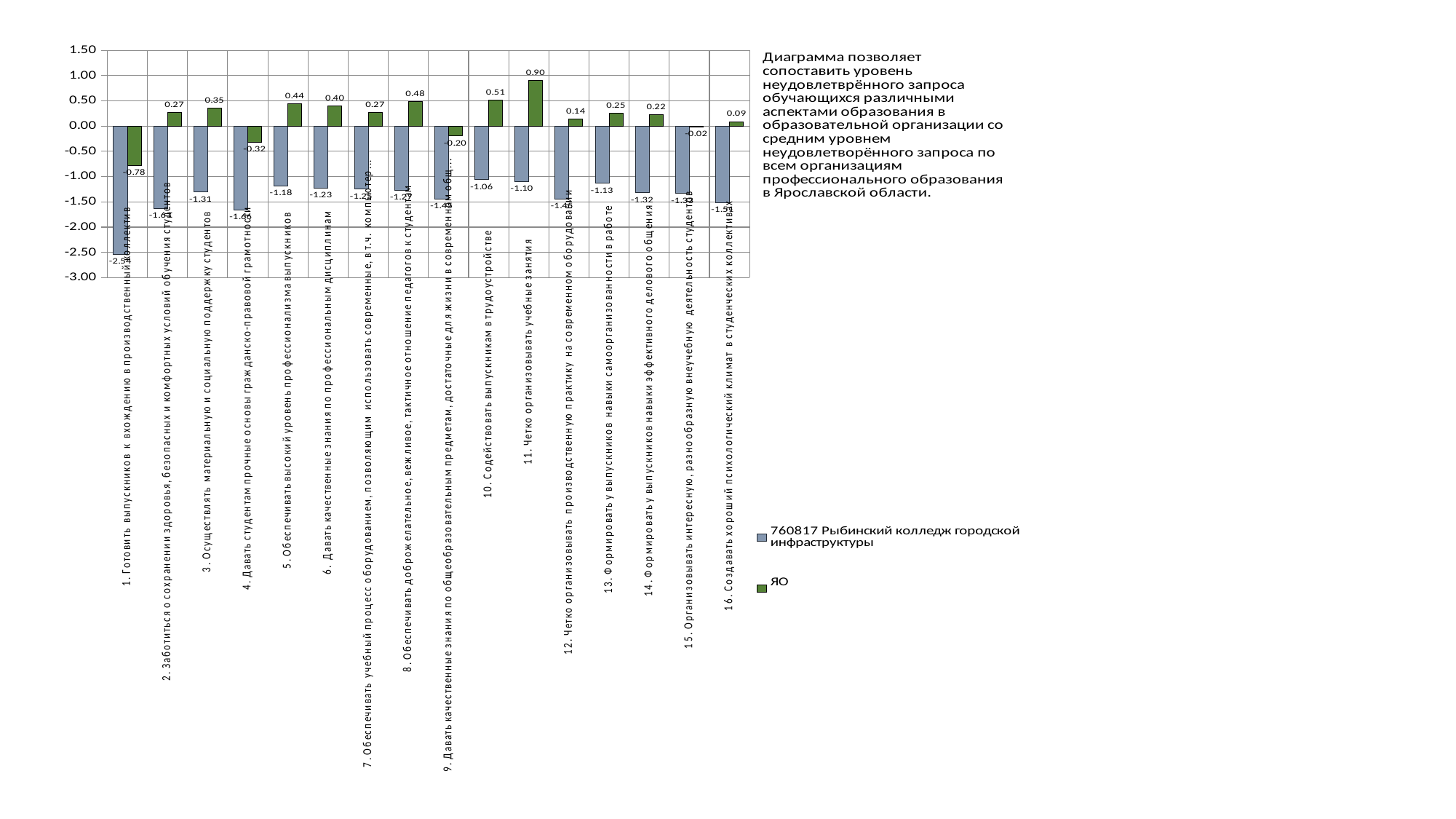
What is the value of the 760817 Рыбинский колледж городской инфраструктуры series for category 5 (Обеспечивать высокий уровень профессионализма выпускников)? -1.18 For which category is the ЯО series highest? 11. Четко организовывать учебные занятия For which category is the 760817 Рыбинский колледж городской инфраструктуры series lowest? 1. Готовить выпускников к вхождению в производственный коллектив How many series does the legend list? 2 What is the value of the ЯО series for category 11 (Четко организовывать учебные занятия)? 0.90 What type of chart is shown on the slide? Bar chart Is the value of the 760817 Рыбинский колледж городской инфраструктуры series for category 1 (Готовить выпускников к вхождению в производственный коллектив) greater or less than -2.00? less What is the difference between the ЯО value and the 760817 Рыбинский колледж городской инфраструктуры value for category 11 (Четко организовывать учебные занятия)? 2.00 What is the value of the ЯО series for category 15 (Организовывать интересную, разнообразную внеучебную деятельность студентов)? -0.02 Which series is shown in green in the legend? ЯО How many categories are plotted on the x axis? 16 For which category is the ЯО series lowest? 1. Готовить выпускников к вхождению в производственный коллектив